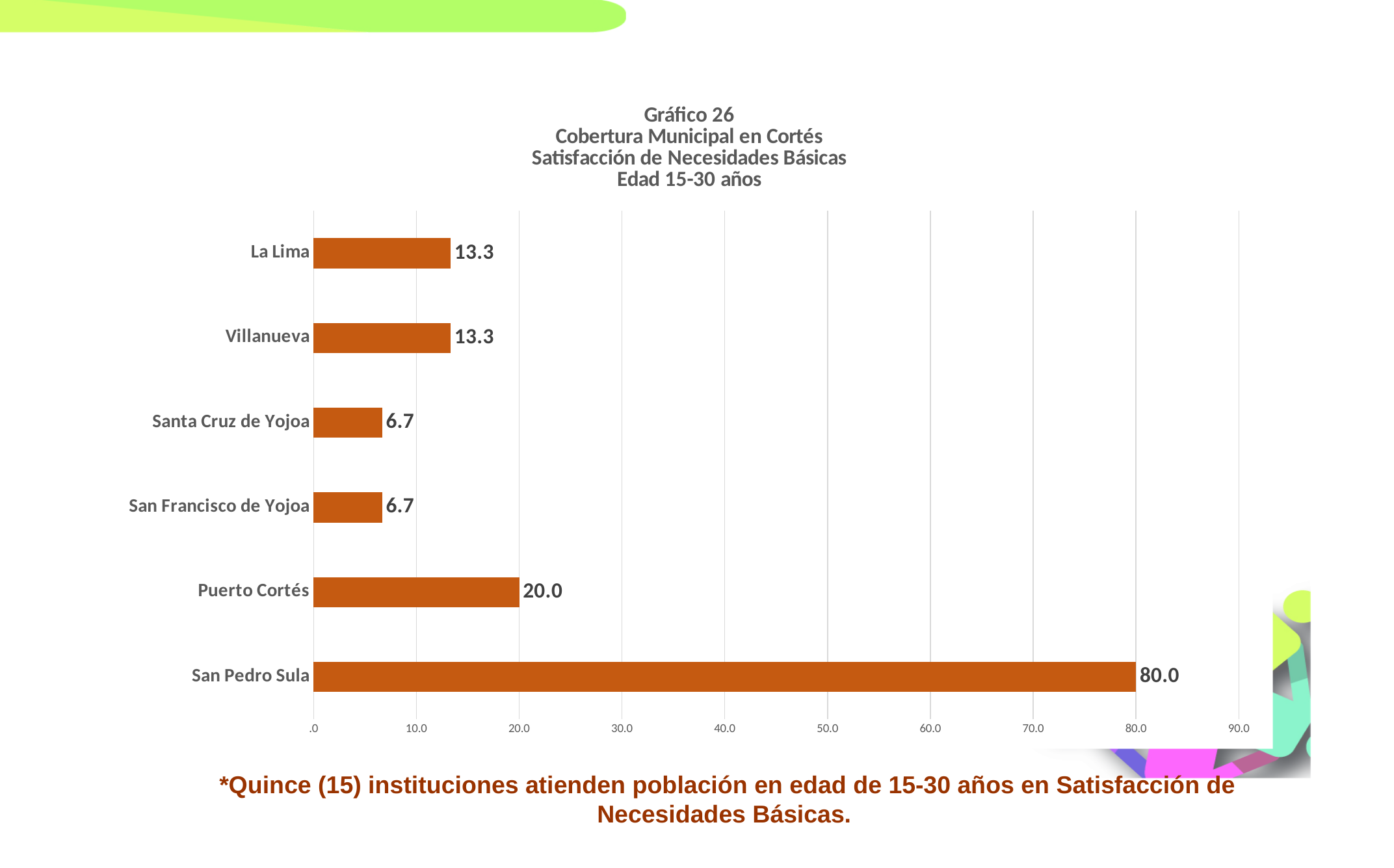
Which municipality has the highest value? San Pedro Sula How many municipalities are shown in the chart? 6 What is the difference between the values for San Pedro Sula and Puerto Cortés? 60.0 What is the value for Santa Cruz de Yojoa? 6.7 Which is larger, the value for Puerto Cortés or the value for Villanueva? Puerto Cortés What is the value for Puerto Cortés? 20.0 What is the value for San Pedro Sula? 80.0 Is the value for San Pedro Sula greater or less than 70.0? greater What is the chart number given in the title? Gráfico 26 What is the value for La Lima? 13.3 What is the difference between the values for Villanueva and San Francisco de Yojoa? 6.6 What kind of chart is shown on the slide? Bar chart